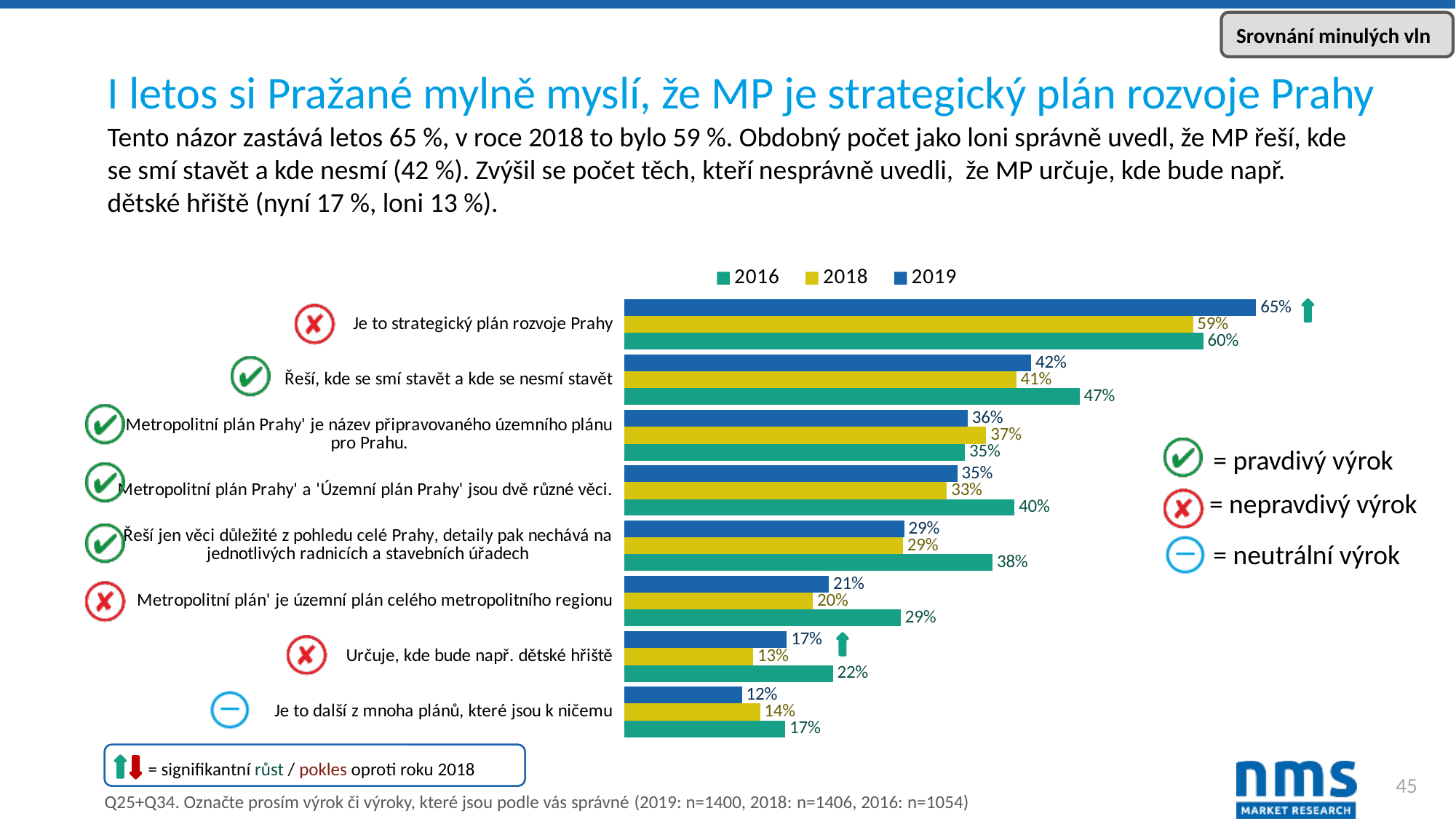
Which statement has the lowest 2019 value? Je to další z mnoha plánů, které jsou k ničemu Which years are listed in the chart legend? 2016, 2018, 2019 For 'Metropolitní plán Prahy' a 'Územní plán Prahy' jsou dvě různé věci', which year has the larger value, 2016 or 2019? 2016 How many statements (categories) are shown in the chart? 8 What is the difference between the 2019 and 2018 values for 'Je to strategický plán rozvoje Prahy'? 6 percentage points How many series does the legend list? 3 What is the 2016 value for 'Řeší, kde se smí stavět a kde se nesmí stavět'? 47% What is the 2018 value for 'Určuje, kde bude např. dětské hřiště'? 13% What is the 2016 value for 'Řeší jen věci důležité z pohledu celé Prahy, detaily pak nechává na jednotlivých radnicích a stavebních úřadech'? 38% What is the 2019 value for 'Je to strategický plán rozvoje Prahy'? 65% Which statement has the highest 2019 value? Je to strategický plán rozvoje Prahy What type of chart is shown on the slide? Bar chart